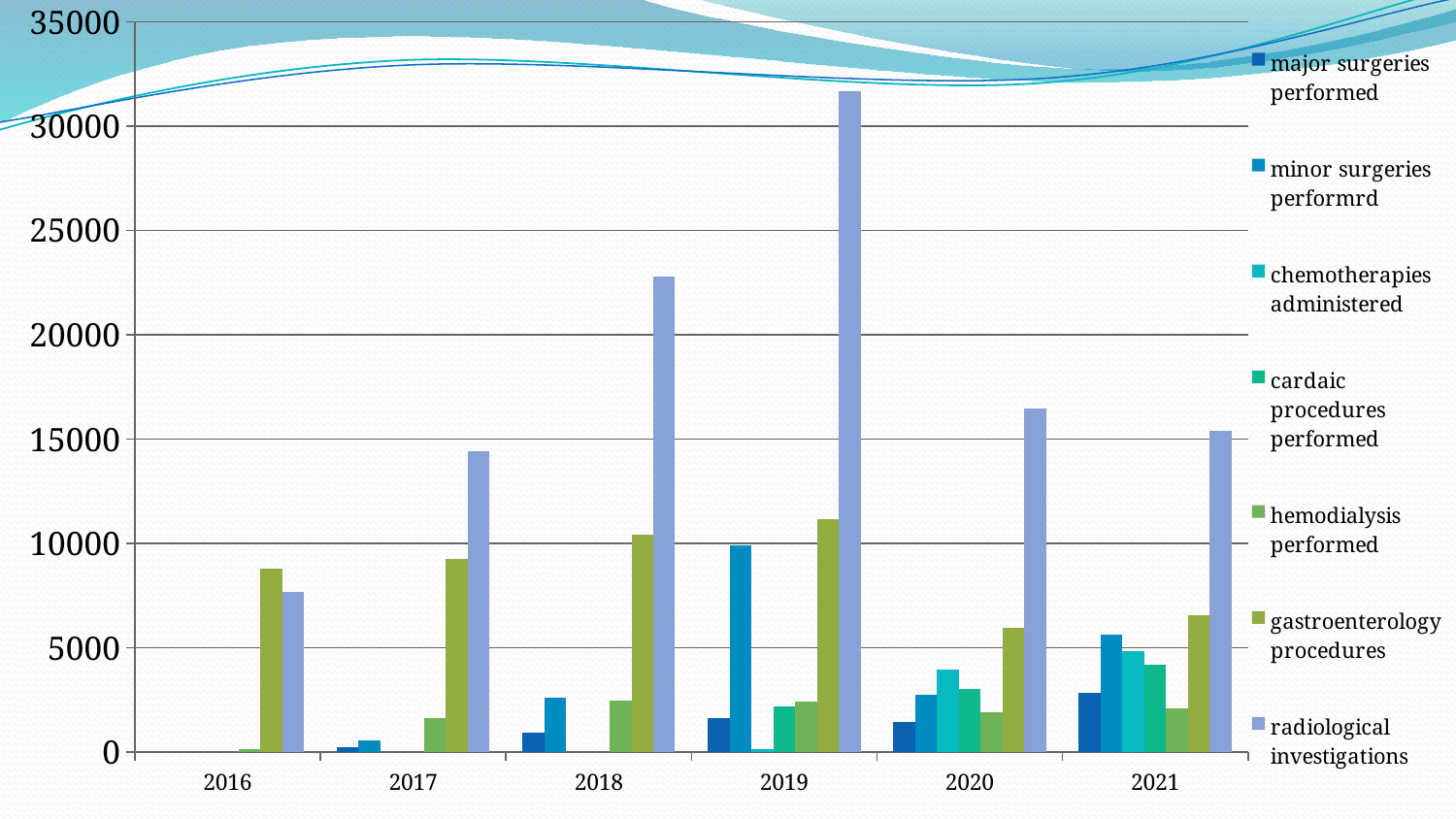
What kind of chart is shown on the slide? bar chart Is the value for minor surgeries performrd in 2021 greater or less than 5000? greater How many years are shown on the x axis? 6 Is the value for radiological investigations in 2018 greater or less than 20000? greater In which year were radiological investigations highest? 2019 Is the value for radiological investigations in 2019 greater or less than 30000? greater In 2019, which is larger: minor surgeries performrd or gastroenterology procedures? gastroenterology procedures In which year were radiological investigations lowest? 2016 How many series does the legend list? 7 In which year were gastroenterology procedures highest? 2019 Do radiological investigations rise or fall from 2016 to 2019? rise